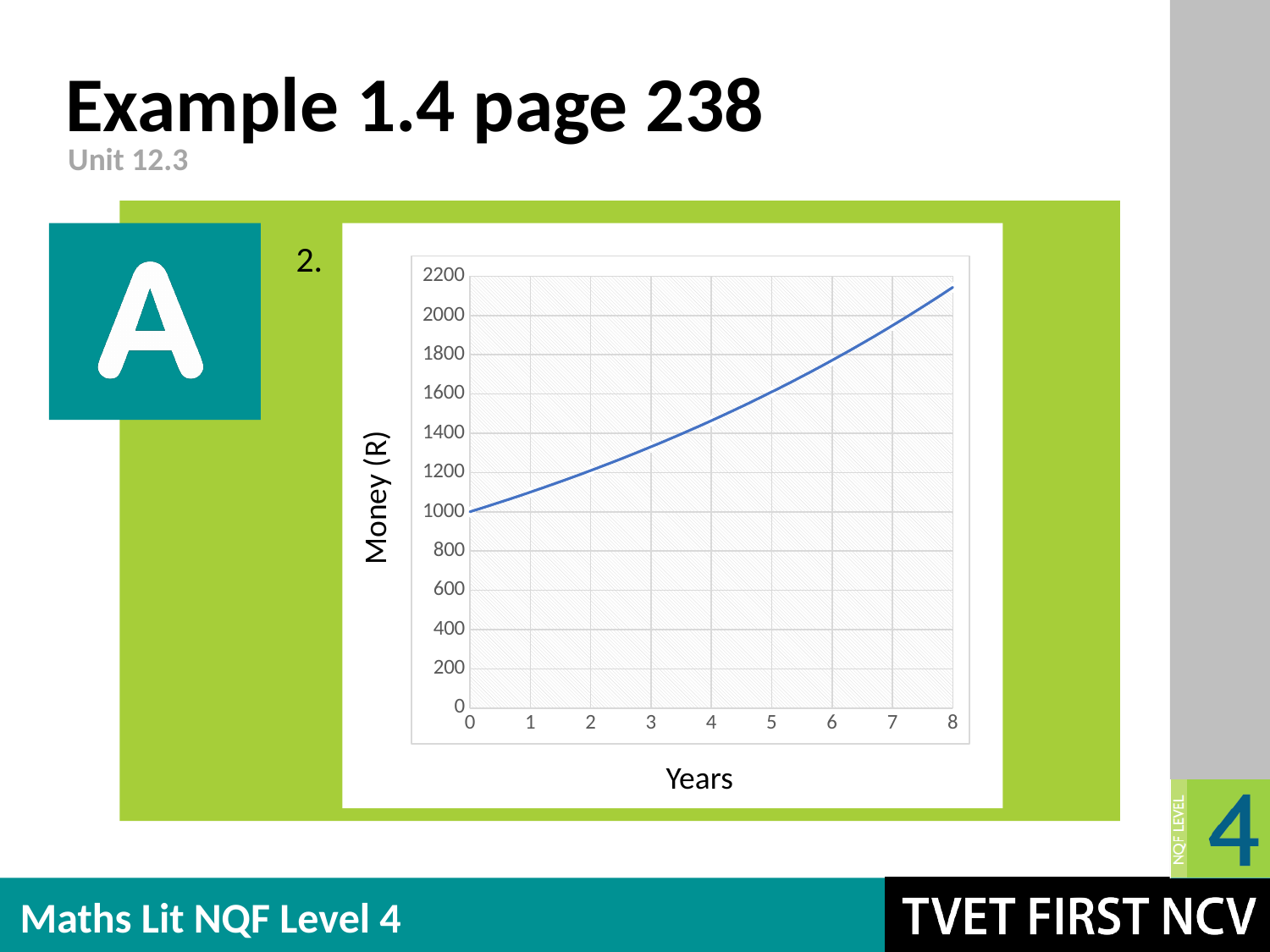
Is the value for Money (R) at 4 years greater or less than 1200? greater What kind of chart is shown on the slide? line chart Is the value for Money (R) at 8 years greater or less than 2000? greater At which year is the Money (R) value lowest? 0 Which is larger, the Money (R) value at 2 years or at 6 years? 6 years At which year is the Money (R) value highest? 8 Is the value for Money (R) at 6 years greater or less than 1600? greater What is the label on the vertical axis of the chart? Money (R) What is the label on the horizontal axis of the chart? Years Do the values on the chart rise or fall as the years increase? rise What is the value of Money (R) at 0 years? 1000